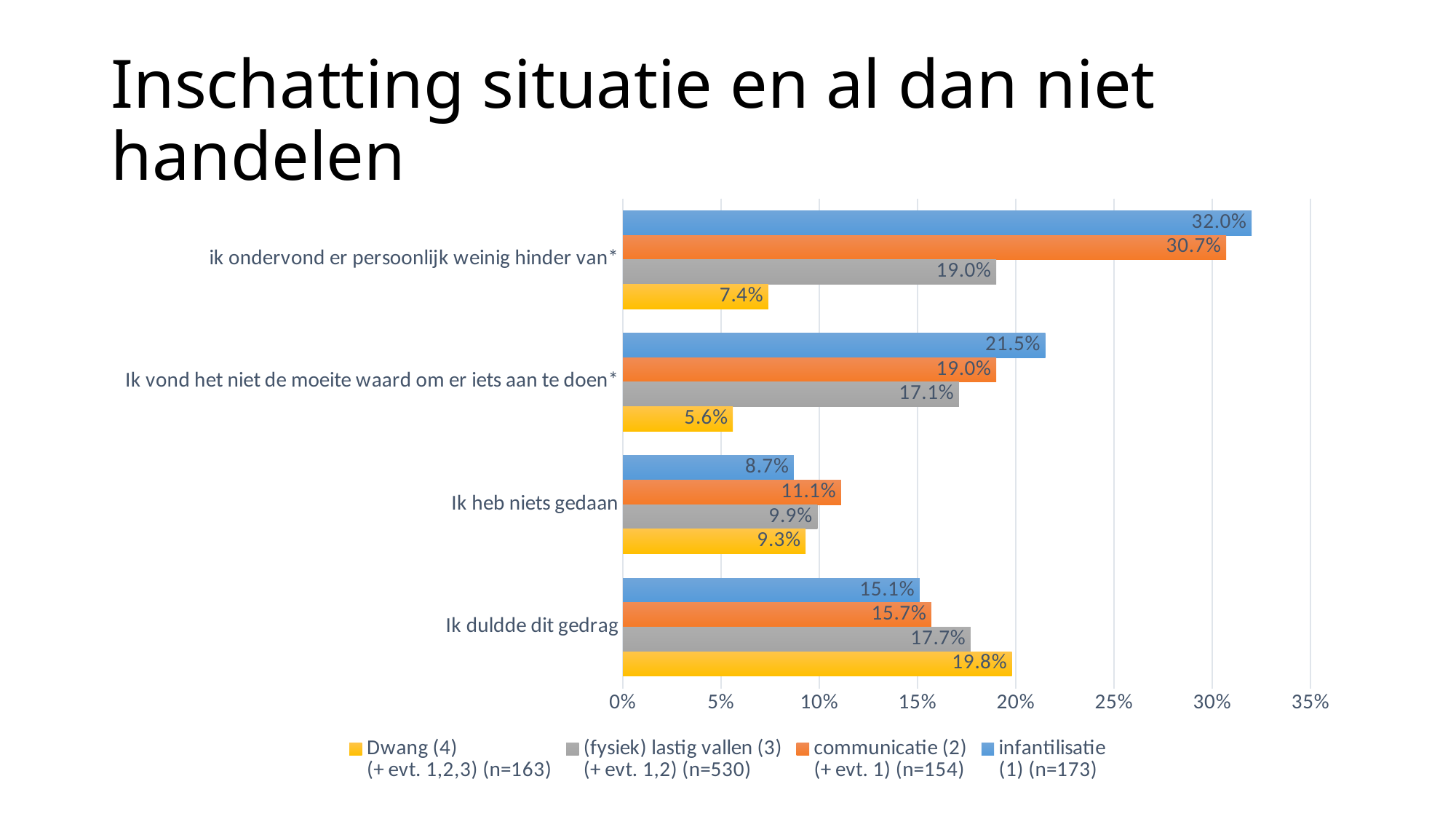
What colour are the bars for the Dwang (4) series? yellow What is the value for Dwang (4) for "Ik duldde dit gedrag"? 19.8% How many categories are shown on the y axis of the chart? 4 Is the value for communicatie (2) for "ik ondervond er persoonlijk weinig hinder van*" greater or less than 25%? greater What kind of chart is shown on the slide? bar chart How many series does the legend list? 4 Which series has the lowest value for "ik ondervond er persoonlijk weinig hinder van*"? Dwang (4) What is the value for infantilisatie (1) for "ik ondervond er persoonlijk weinig hinder van*"? 32.0% Which series has the highest value for "Ik vond het niet de moeite waard om er iets aan te doen*"? infantilisatie (1) For "Ik duldde dit gedrag", which is larger: the value for (fysiek) lastig vallen (3) or for communicatie (2)? (fysiek) lastig vallen (3) What is the difference between the infantilisatie (1) and Dwang (4) values for "Ik vond het niet de moeite waard om er iets aan te doen*"? 15.9% What is the value for communicatie (2) for "Ik heb niets gedaan"? 11.1%